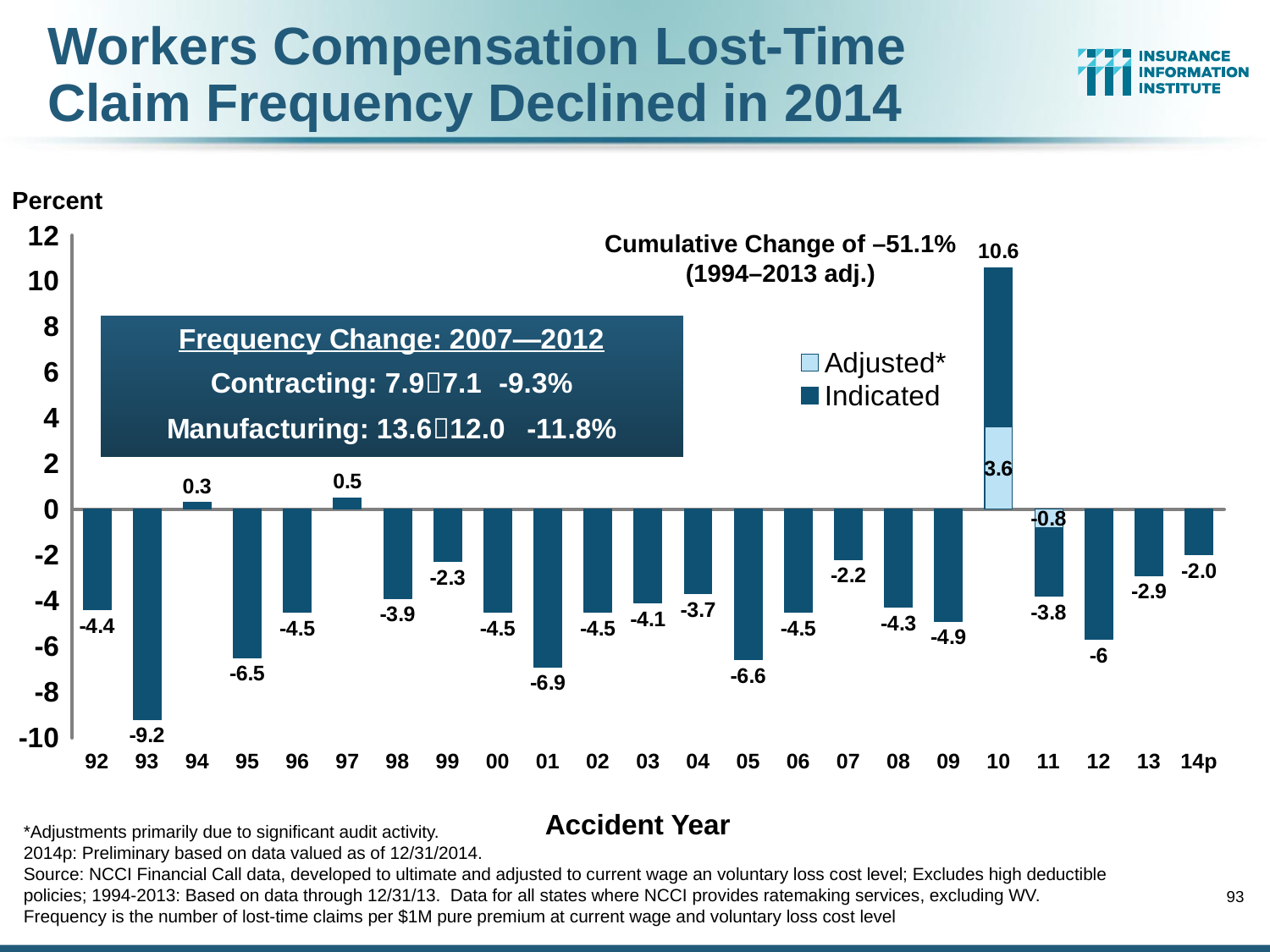
What is the value for accident year 93? -9.2 Which accident year has a larger value, 01 or 05? 05 What is the Indicated value for accident year 10? 10.6 What is the value for accident year 14p? -2.0 How many accident years are shown on the x axis? 23 What is the difference between the values for accident years 12 and 13? 3.1 What kind of chart is shown on the slide? Bar chart How many series does the legend list? 2 Which accident year has the highest value? 10 What are the two series named in the legend? Adjusted* and Indicated What is the Adjusted value for accident year 10? 3.6 Which accident year has the lowest value? 93